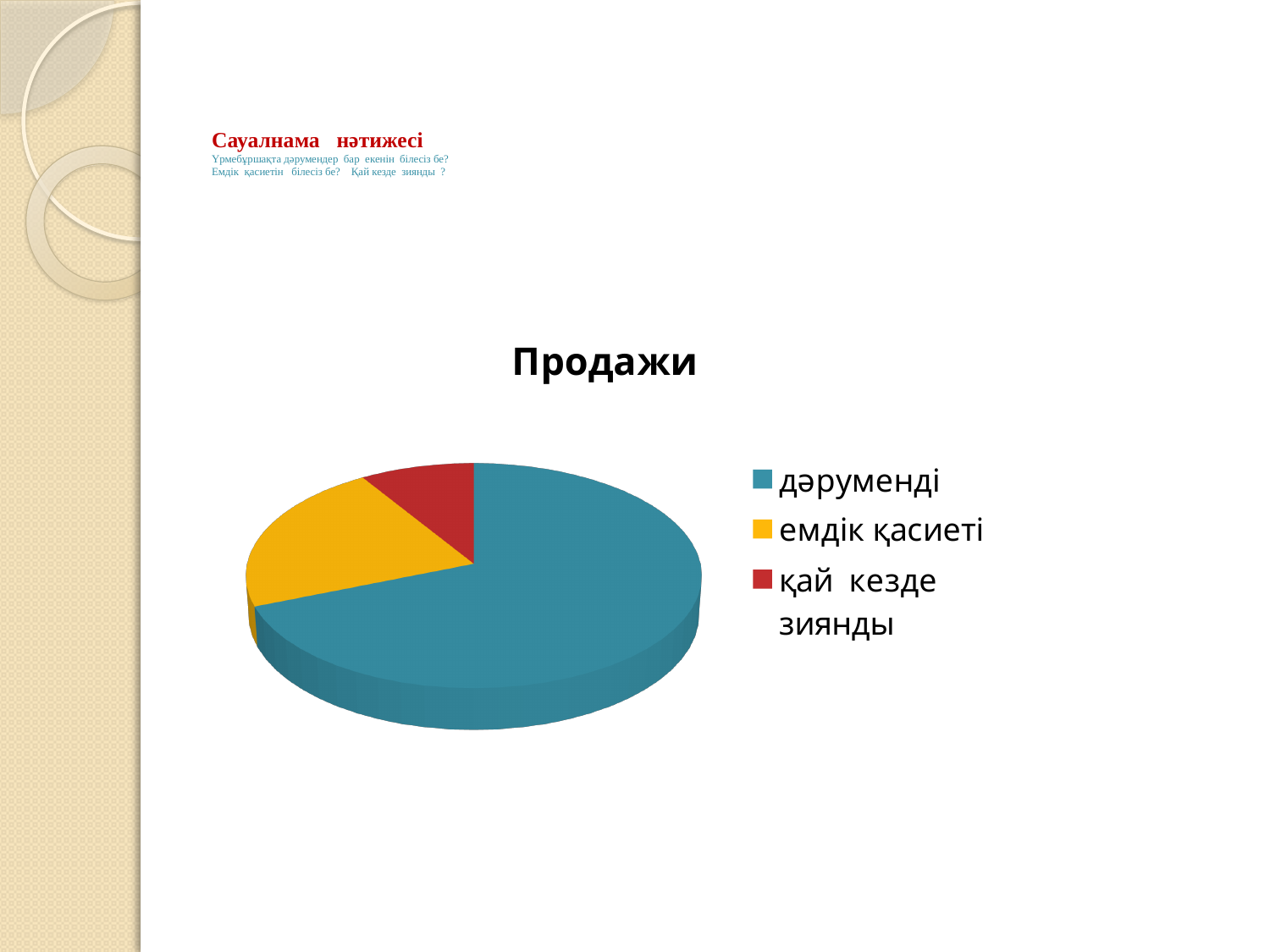
How many slices does the pie chart have? 3 Which slice is larger, емдік қасиеті or қай кезде зиянды? емдік қасиеті How many entries does the legend list? 3 What is the title of the chart? Продажи Which slice is larger, дәруменді or емдік қасиеті? дәруменді Which category has the largest slice of the pie? дәруменді Which category has the smallest slice of the pie? қай кезде зиянды What kind of chart is shown on the slide? pie chart What colour is the slice for дәруменді? teal (blue-green)